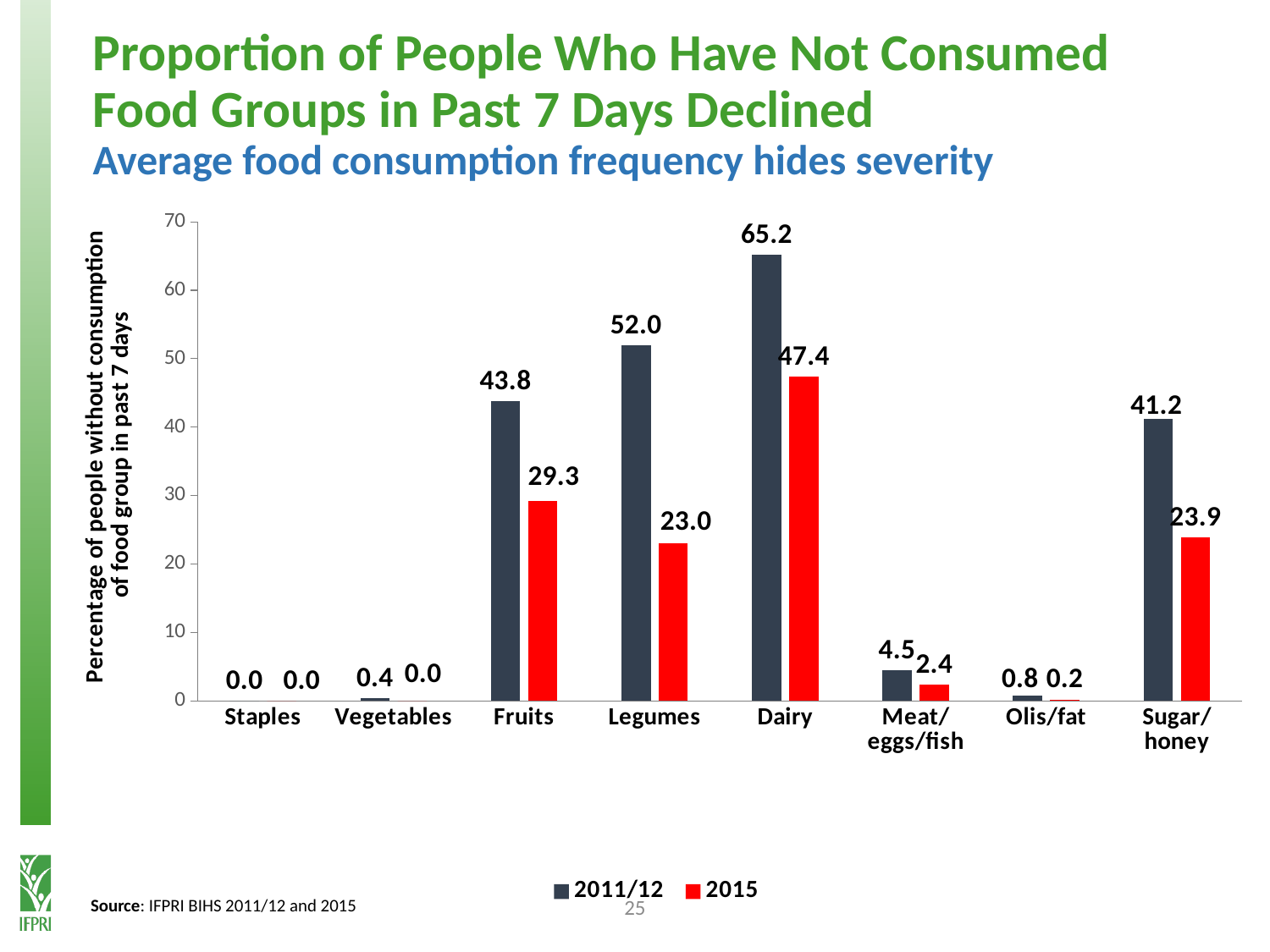
What is the value for Sugar/honey in 2015? 23.9 How many series does the legend list? 2 Which is larger: the 2015 value for Fruits or the 2015 value for Sugar/honey? Fruits How many food groups are shown on the x axis? 8 What is the difference between the 2011/12 and 2015 values for Dairy? 17.8 Which food group has the lowest value in 2015? Staples and Vegetables (both 0.0) Which food group has the highest value in 2011/12? Dairy Which colour represents the 2015 series in the chart? Red What is the value for Fruits in 2015? 29.3 What is the difference between the 2011/12 and 2015 values for Legumes? 29.0 What is the value for Dairy in 2011/12? 65.2 What kind of chart is shown on the slide? Bar chart